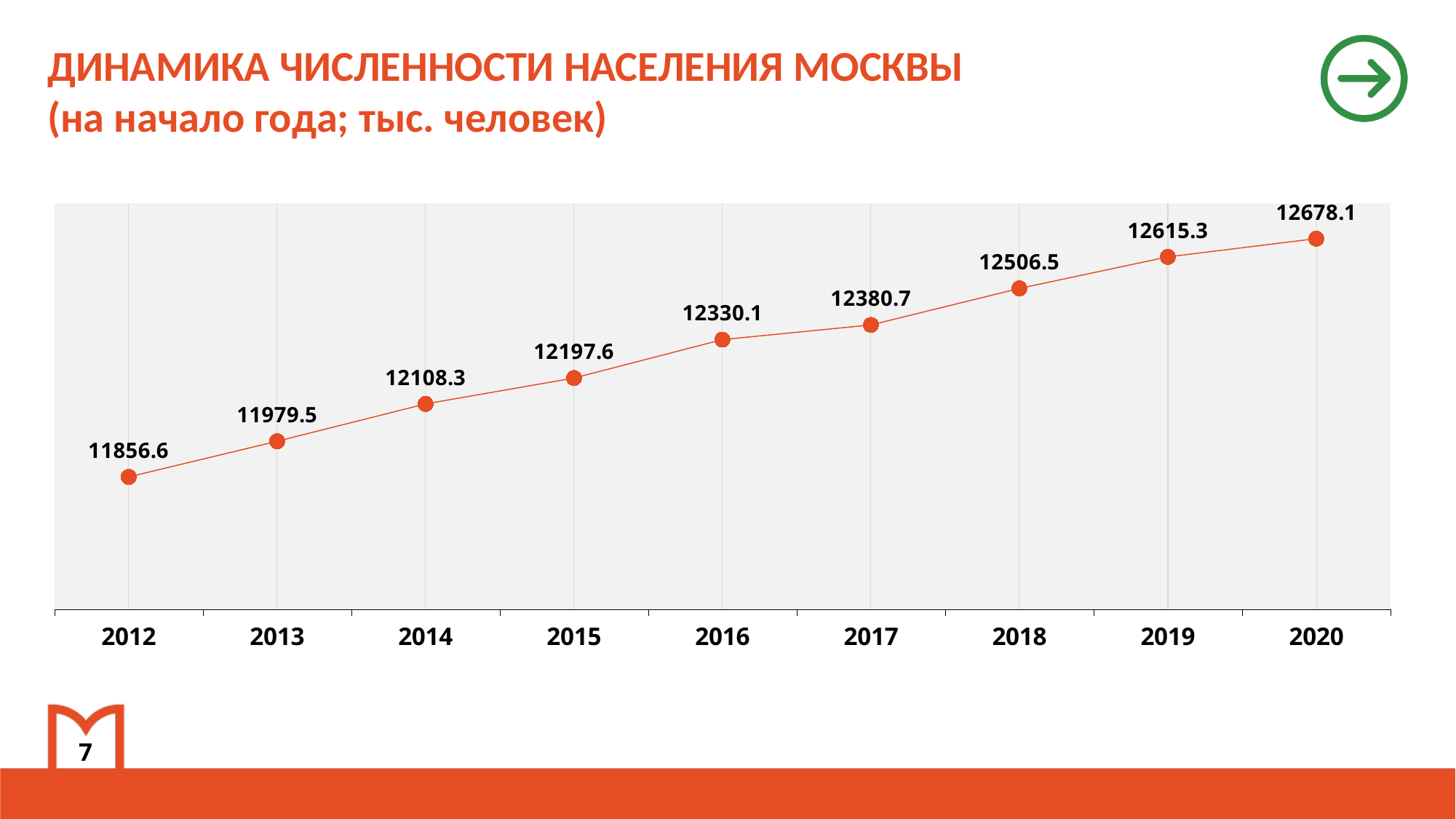
What is the difference between the values for 2020 and 2012? 821.5 What type of chart is shown on the slide? line chart How many years are plotted on the chart? 9 What is the population value shown for 2012? 11856.6 What is the population value shown for 2020? 12678.1 What is the population value shown for 2018? 12506.5 Do the values rise or fall from 2012 to 2020? rise What is the population value shown for 2016? 12330.1 What is the difference between the values for 2018 and 2017? 125.8 Which year has the lowest population value? 2012 Which year has the highest population value? 2020 Which is larger, the value for 2015 or the value for 2017? 2017